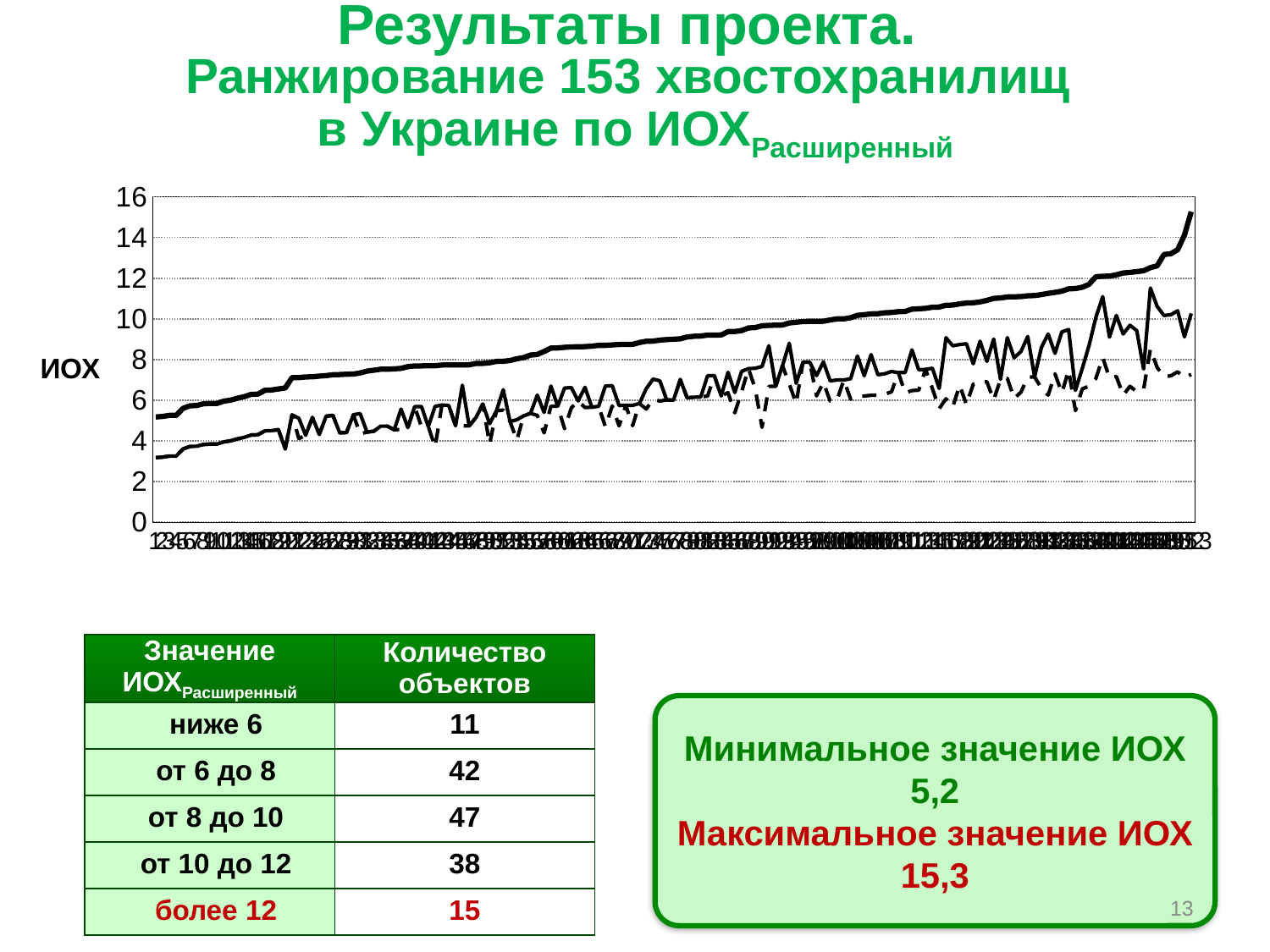
Is the value of the thin solid line at the far left of the chart greater or less than 4? less Is the value of the thick solid line at the far right of the chart greater or less than 16? less Is the value of the thick solid line at the far right of the chart greater or less than 14? greater What is the label of the vertical axis of the chart? ИОХ What is the highest tick value shown on the vertical axis of the chart? 16 Which line lies highest on the chart across its whole length: the thick solid line, the thin solid line, or the dashed line? the thick solid line Does the thick solid line rise or fall from left to right along the x axis? rises What kind of chart is shown on the slide? line chart How many lines are plotted on the chart? 3